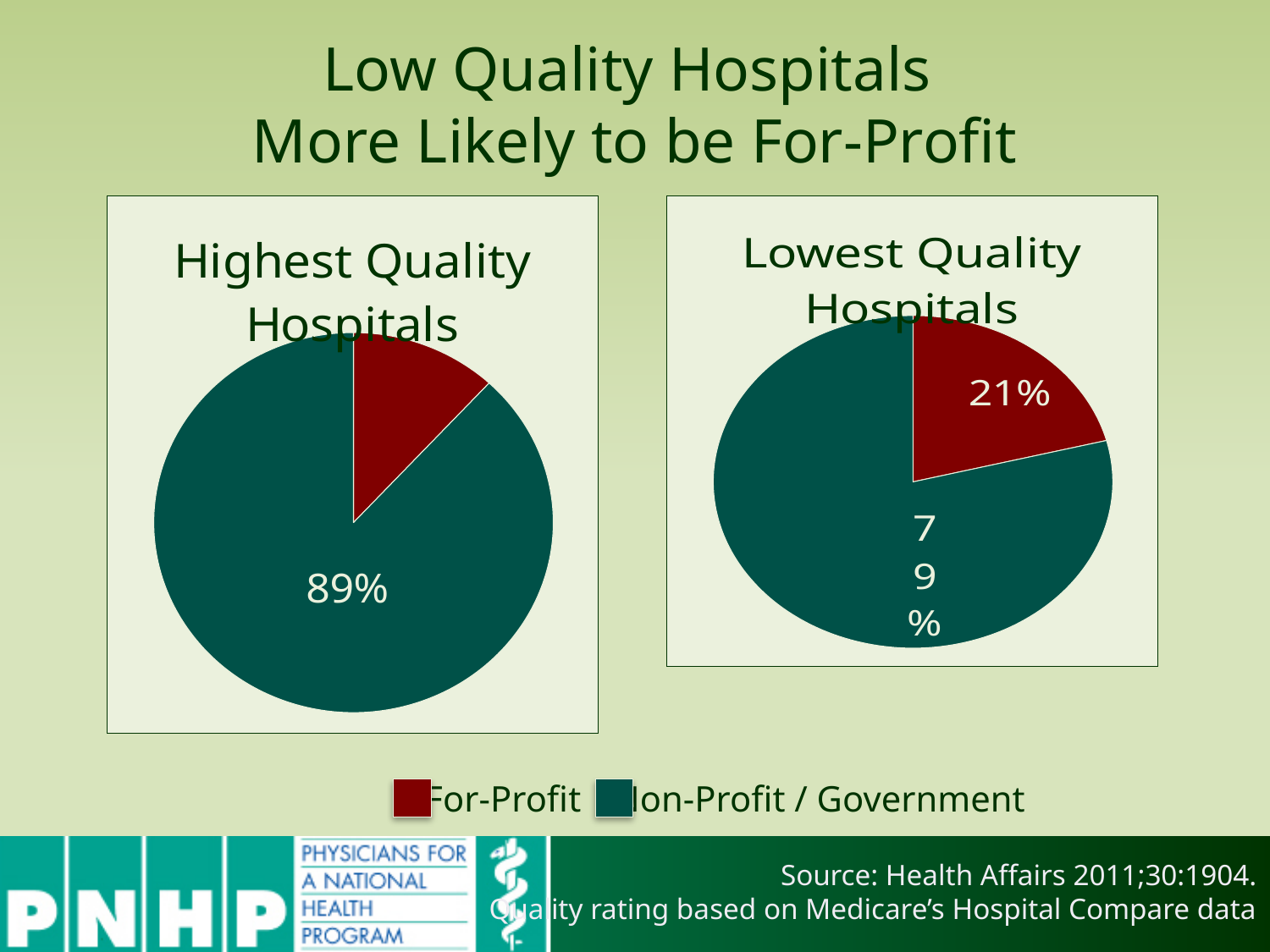
In the Lowest Quality Hospitals pie chart, what share is Non-Profit / Government? 79% What colour represents For-Profit in the legend? Red In the Lowest Quality Hospitals pie chart, which slice is the largest? Non-Profit / Government How many slices does the Lowest Quality Hospitals pie chart have? 2 In the Highest Quality Hospitals pie chart, which slice is the smallest? For-Profit How many entries does the legend list? 2 In the Highest Quality Hospitals pie chart, what share is Non-Profit / Government? 89% Is the For-Profit slice larger in the Highest Quality Hospitals chart or the Lowest Quality Hospitals chart? Lowest Quality Hospitals What is the title of the pie chart on the left? Highest Quality Hospitals In the Lowest Quality Hospitals pie chart, how many percentage points larger is the Non-Profit / Government share than the For-Profit share? 58 percentage points In the Lowest Quality Hospitals pie chart, what share is For-Profit? 21% What kind of chart is used for the Highest Quality Hospitals data? Pie chart